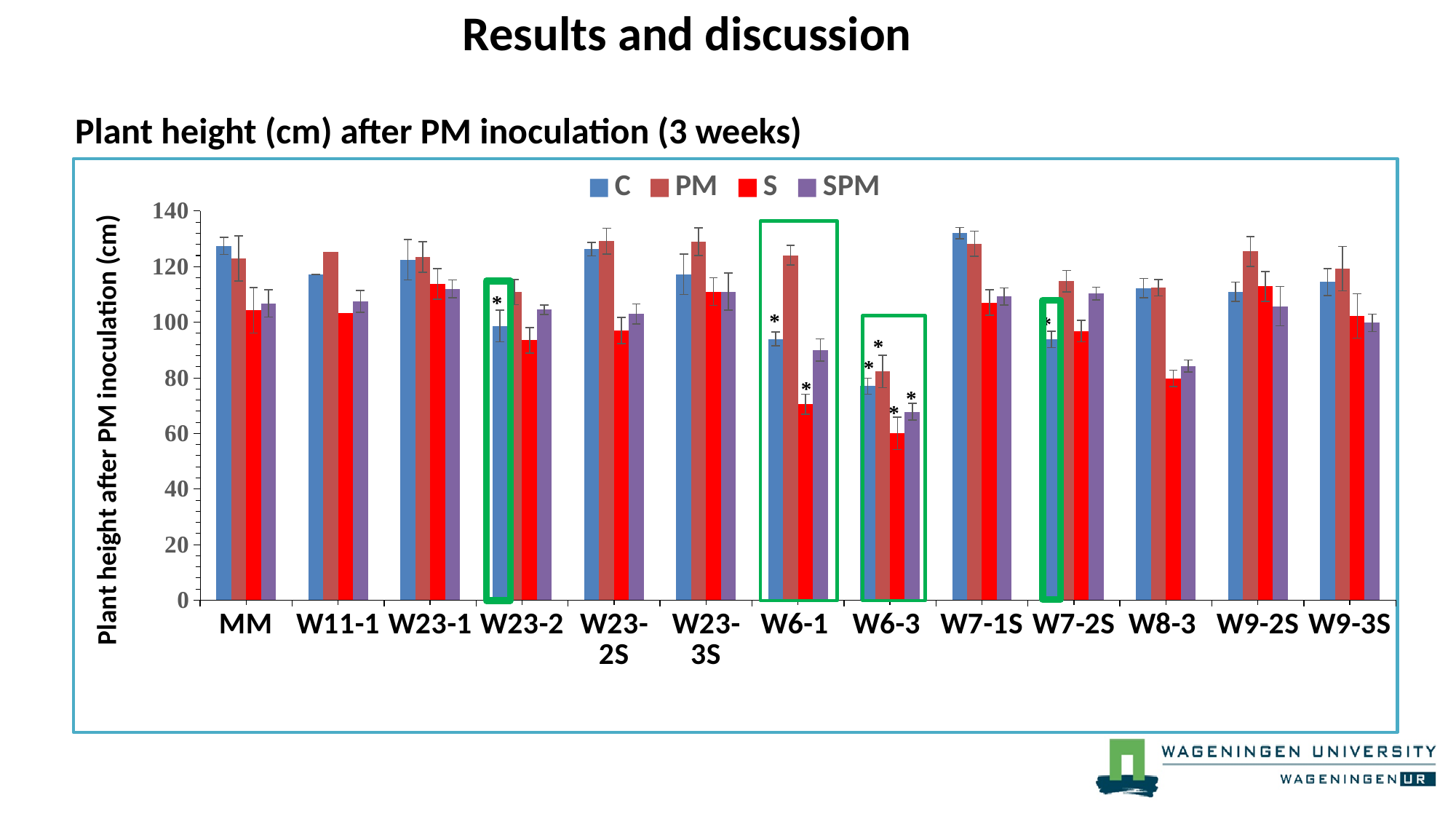
Is the value of the C series for W6-3 greater or less than 100? less Is the value of the C series for W7-1S greater or less than 120? greater Is the value of the S series for W6-3 greater or less than 80? less Which category has the lowest value in the SPM series? W6-3 Which category has the lowest value in the S series? W6-3 What is the title of the y axis? Plant height after PM inoculation (cm) What kind of chart is shown on the slide? bar chart How many categories are shown along the x axis? 13 How many series does the legend list? 4 For W6-1, which is larger: the PM value or the S value? PM